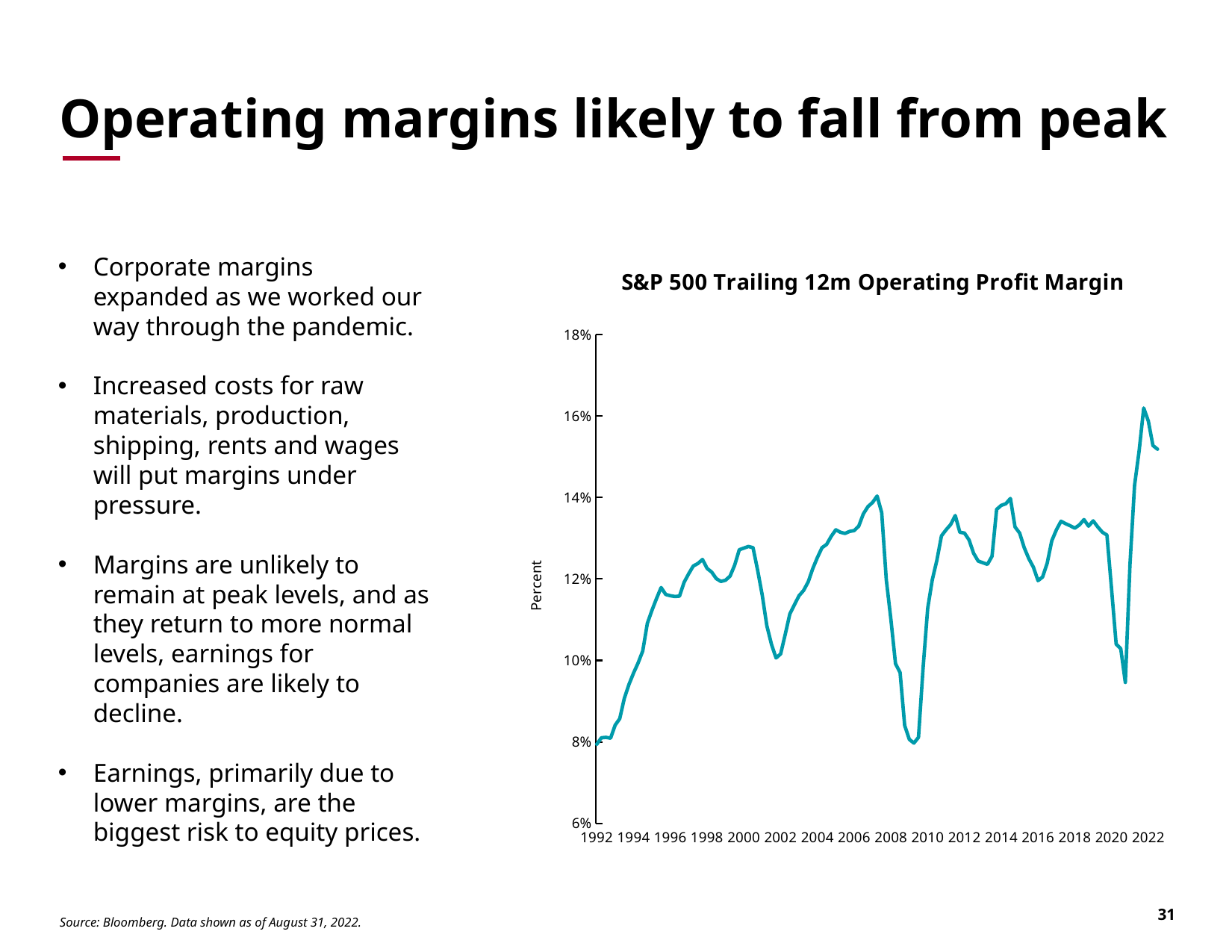
Which is higher, the operating profit margin around 2007 or around 2009? 2007 Is the operating profit margin around 2009 greater or less than 10%? less What kind of chart is shown on the slide? Line chart Is the operating profit margin at the 2021 peak greater or less than 14%? greater How many year labels are shown on the x axis of the chart? 16 What is the label on the vertical axis of the chart? Percent Is the operating profit margin around 2007 greater or less than 12%? greater What is the title of the chart? S&P 500 Trailing 12m Operating Profit Margin Does the operating profit margin rise or fall between 1992 and 1996? rise How many lines are plotted on the chart? 1 Does the operating profit margin rise or fall between 2007 and 2009? fall